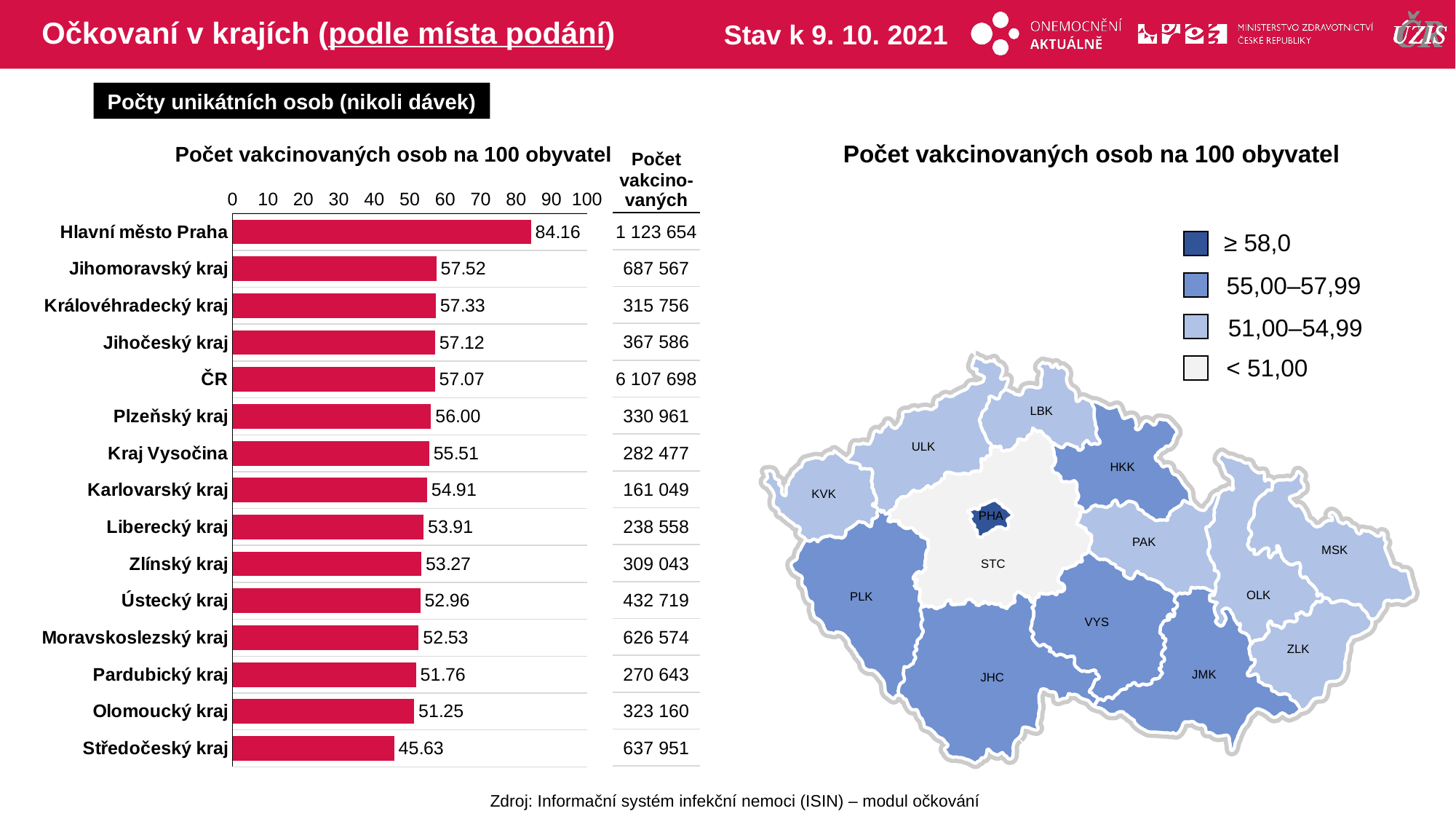
In the bar chart, what is the value for ČR? 57.07 Which category has the lowest value in the bar chart? Středočeský kraj How many bars are shown in the bar chart? 15 Which category has the highest value in the bar chart? Hlavní město Praha What kind of chart is shown on the left of the slide? bar chart What is the value for Hlavní město Praha in the bar chart 'Počet vakcinovaných osob na 100 obyvatel'? 84.16 In the bar chart, what is the difference between the values for Hlavní město Praha and Středočeský kraj? 38.53 In the bar chart, which is larger: the value for Karlovarský kraj or Liberecký kraj? Karlovarský kraj In the bar chart, what is the value for Středočeský kraj? 45.63 In the bar chart, is the value for Hlavní město Praha greater or less than 80? greater In the bar chart, what is the value for Kraj Vysočina? 55.51 How many categories does the legend of the map on the right list? 4